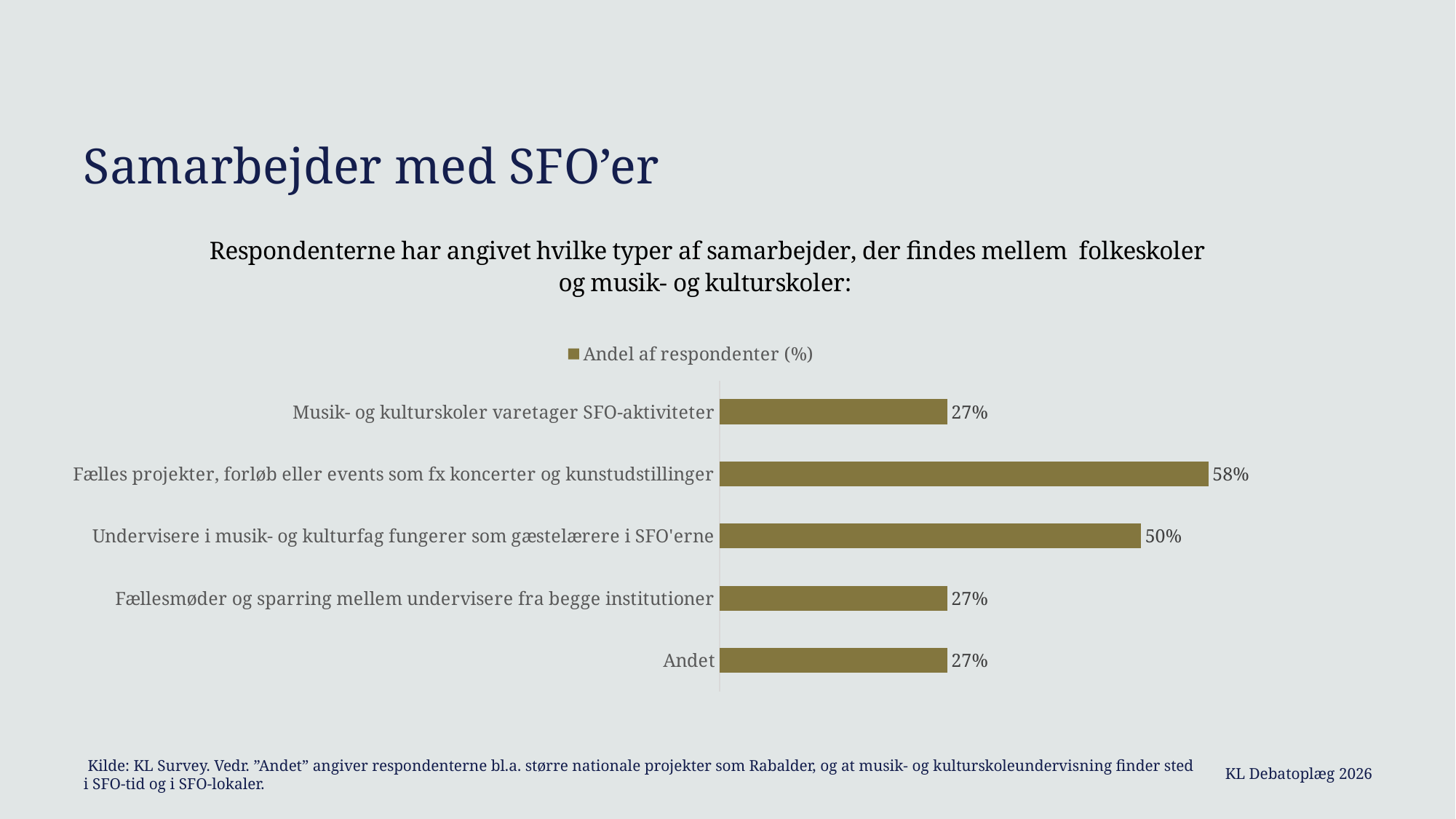
Which category has the highest value? Fælles projekter, forløb eller events som fx koncerter og kunstudstillinger What kind of chart is shown on the slide? Bar chart What is the difference between the values for "Fælles projekter, forløb eller events som fx koncerter og kunstudstillinger" and "Undervisere i musik- og kulturfag fungerer som gæstelærere i SFO'erne"? 8% Which is larger: the value for "Fælles projekter, forløb eller events som fx koncerter og kunstudstillinger" or the value for "Fællesmøder og sparring mellem undervisere fra begge institutioner"? Fælles projekter, forløb eller events som fx koncerter og kunstudstillinger What is the value for "Undervisere i musik- og kulturfag fungerer som gæstelærere i SFO'erne"? 50% What is the value for "Andet"? 27% What is the value for "Musik- og kulturskoler varetager SFO-aktiviteter"? 27% What is the value for "Fælles projekter, forløb eller events som fx koncerter og kunstudstillinger"? 58% How many series does the legend list? 1 What is the difference between the values for "Undervisere i musik- og kulturfag fungerer som gæstelærere i SFO'erne" and "Andet"? 23% What is the legend entry of the chart? Andel af respondenter (%) How many categories are shown in the chart? 5